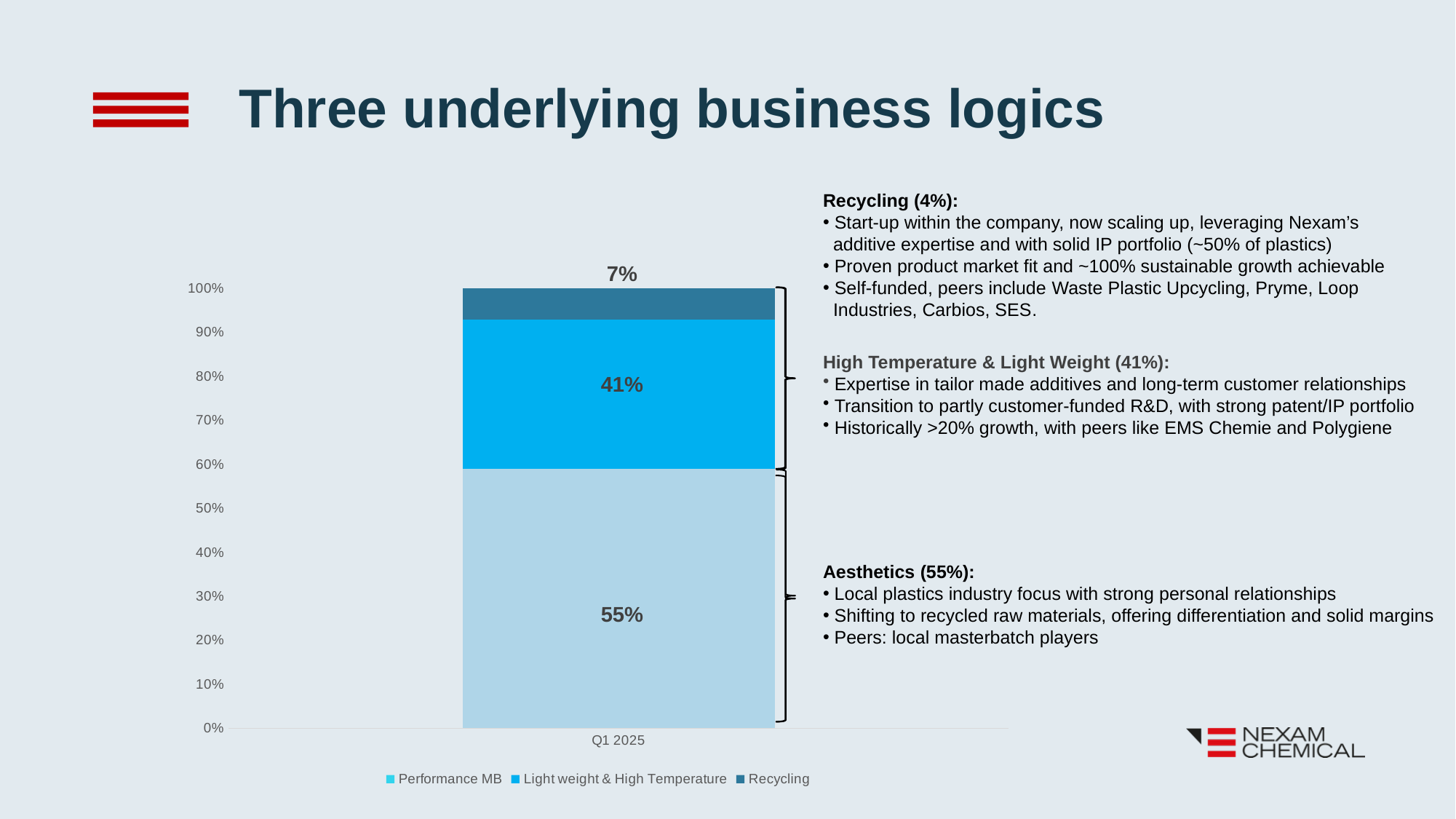
How many series does the legend list? 3 What is the category label on the x axis? Q1 2025 What is the value for Light weight & High Temperature in Q1 2025? 41% Which is larger, the Light weight & High Temperature value or the Recycling value? Light weight & High Temperature Which series has the largest share of the Q1 2025 bar? Performance MB Which series is shown in the darkest blue at the top of the bar? Recycling Which series has the smallest share of the Q1 2025 bar? Recycling What is the value for Recycling in Q1 2025? 7% What kind of chart is shown on the slide? Stacked bar chart How many categories are shown on the x axis? 1 What is the value for Performance MB in Q1 2025? 55% What is the difference between the Performance MB value and the Light weight & High Temperature value? 14%